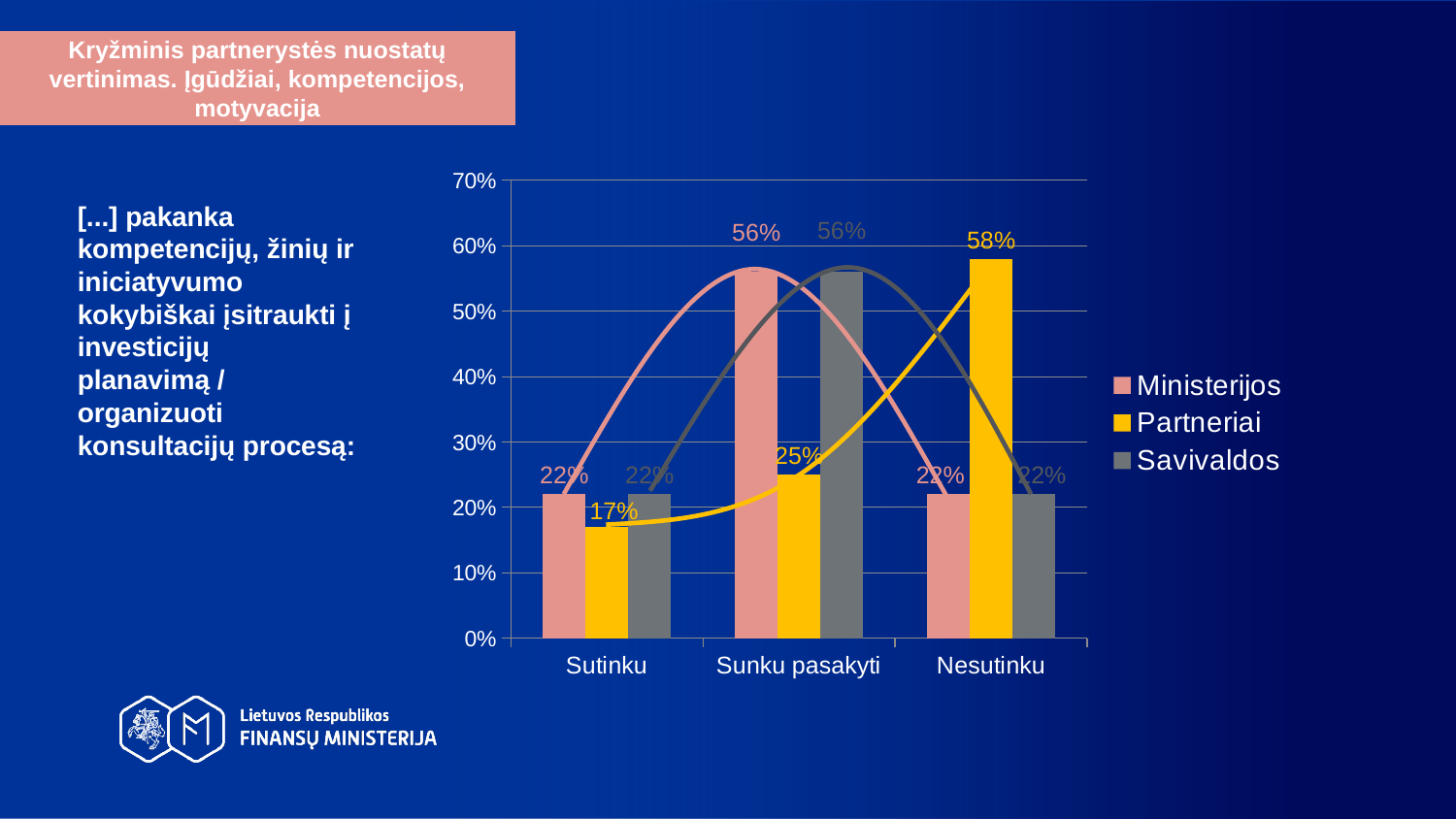
What is the value for Partneriai in the Nesutinku category? 58% How many series does the legend list? 3 In which category does the Partneriai series reach its highest value? Nesutinku What is the value for Partneriai in the Sutinku category? 17% What is the value for Savivaldos in the Nesutinku category? 22% What is the difference between the Partneriai value in Nesutinku and the Partneriai value in Sutinku? 41% In which category does the Partneriai series have its lowest value? Sutinku What is the value for Ministerijos in the Sunku pasakyti category? 56% In the Sunku pasakyti category, which is larger: the Ministerijos value or the Partneriai value? Ministerijos How many categories are shown on the x axis? 3 Which colour represents the Partneriai series in the legend? Yellow What kind of chart is shown on the slide? Bar chart